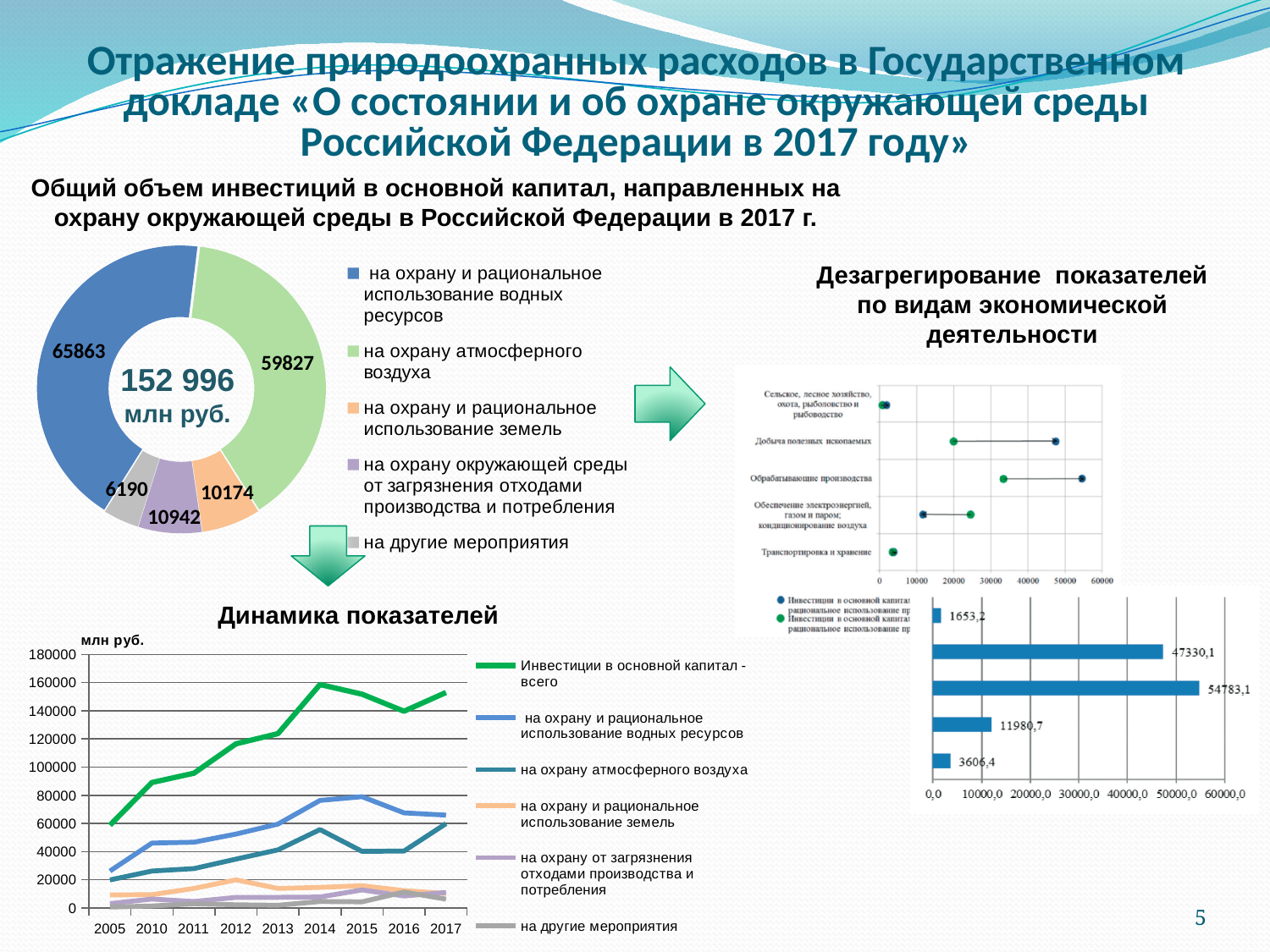
On the donut chart, what is the value for protection of atmospheric air (на охрану атмосферного воздуха)? 59827 On the donut chart, which is larger: the value for protection of land (на охрану и рациональное использование земель) or the value for protection from waste pollution (на охрану окружающей среды от загрязнения отходами)? на охрану окружающей среды от загрязнения отходами On the donut chart of total investment in fixed capital for environmental protection in 2017, what total value is printed in the centre? 152 996 млн руб. On the donut chart, which category has the smallest value? на другие мероприятия On the bar chart in the bottom right corner of the slide, what is the largest labelled value? 54783,1 On the donut chart, what is the difference between the value for water resources (65863) and the value for atmospheric air (59827)? 6036 On the 'Динамика показателей' chart, how many years are shown on the x axis? 9 How many series does the legend of the 'Динамика показателей' line chart list? 6 On the 'Динамика показателей' chart, is the value of 'Инвестиции в основной капитал - всего' in 2014 greater or less than 140000? greater What type of chart is the chart in the bottom right corner of the slide with the labels 1653,2 and 54783,1? bar chart On the donut chart, what is the value for investment in protection and rational use of water resources (на охрану и рациональное использование водных ресурсов)? 65863 On the 'Динамика показателей' chart, is the value of 'Инвестиции в основной капитал - всего' in 2005 greater or less than 80000? less